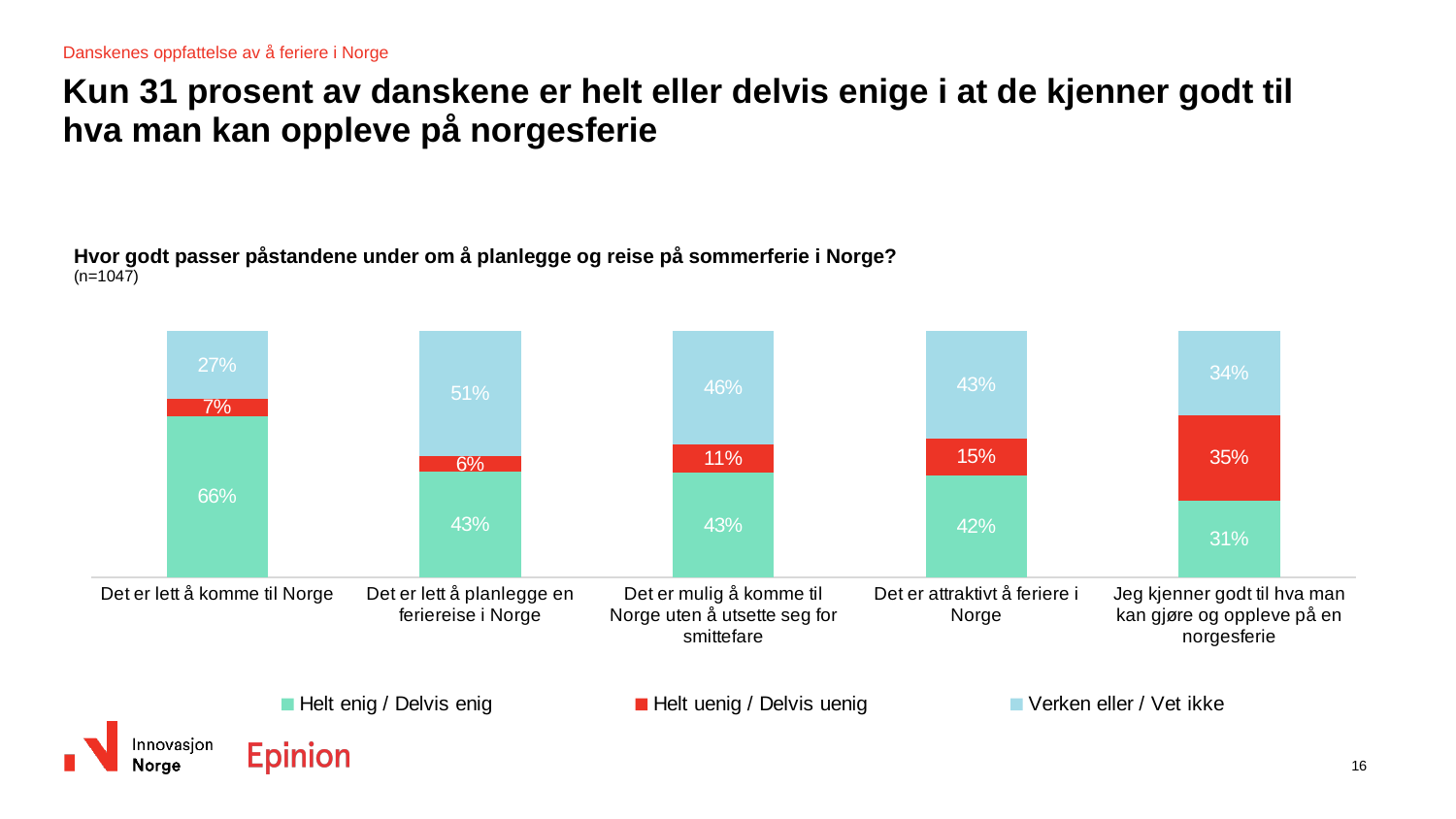
What kind of chart is shown on the slide? Stacked bar chart What is the difference between the "Helt enig / Delvis enig" values for "Det er lett å komme til Norge" and "Jeg kjenner godt til hva man kan gjøre og oppleve på en norgesferie"? 35 percentage points What is the "Helt uenig / Delvis uenig" value for "Det er attraktivt å feriere i Norge"? 15% How many statements (categories) are shown on the x axis of the chart? 5 Which statement has the highest "Helt enig / Delvis enig" share? Det er lett å komme til Norge What is the "Verken eller / Vet ikke" value for "Det er lett å planlegge en feriereise i Norge"? 51% What percentage of respondents answered "Helt enig / Delvis enig" for "Det er lett å komme til Norge"? 66% Which colour represents "Helt uenig / Delvis uenig" in the chart? Red Which is larger: the "Helt uenig / Delvis uenig" share for "Det er mulig å komme til Norge uten å utsette seg for smittefare" or for "Det er attraktivt å feriere i Norge"? Det er attraktivt å feriere i Norge Which statement has the lowest "Helt uenig / Delvis uenig" share? Det er lett å planlegge en feriereise i Norge How many series does the legend list? 3 What is the total of the stacked bar for "Jeg kjenner godt til hva man kan gjøre og oppleve på en norgesferie"? 100%